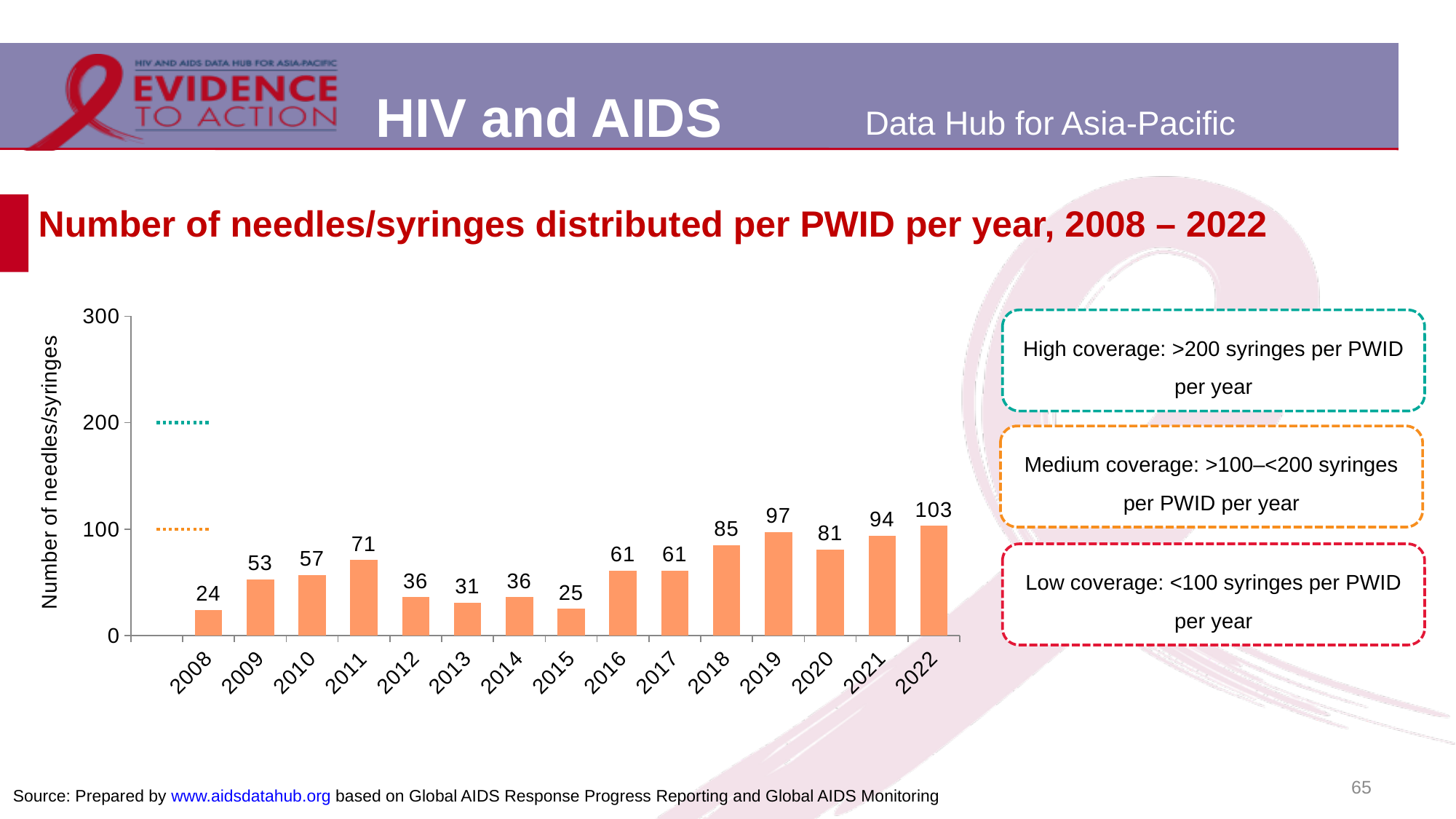
What is the value shown for 2019? 97 What kind of chart is shown on the slide? bar chart Which year has the highest number of needles/syringes distributed per PWID? 2022 Which year has a larger value, 2011 or 2015? 2011 What is the difference between the values for 2022 and 2008? 79 What is the value shown for 2008? 24 How many years are shown on the x axis of the chart? 15 Do the values generally rise or fall from 2015 to 2019? rise Which year has the lowest number of needles/syringes distributed per PWID? 2008 Is the value for 2021 greater or less than 100? less What is the number of needles/syringes distributed per PWID per year in 2022? 103 What is the label of the y axis of the chart? Number of needles/syringes